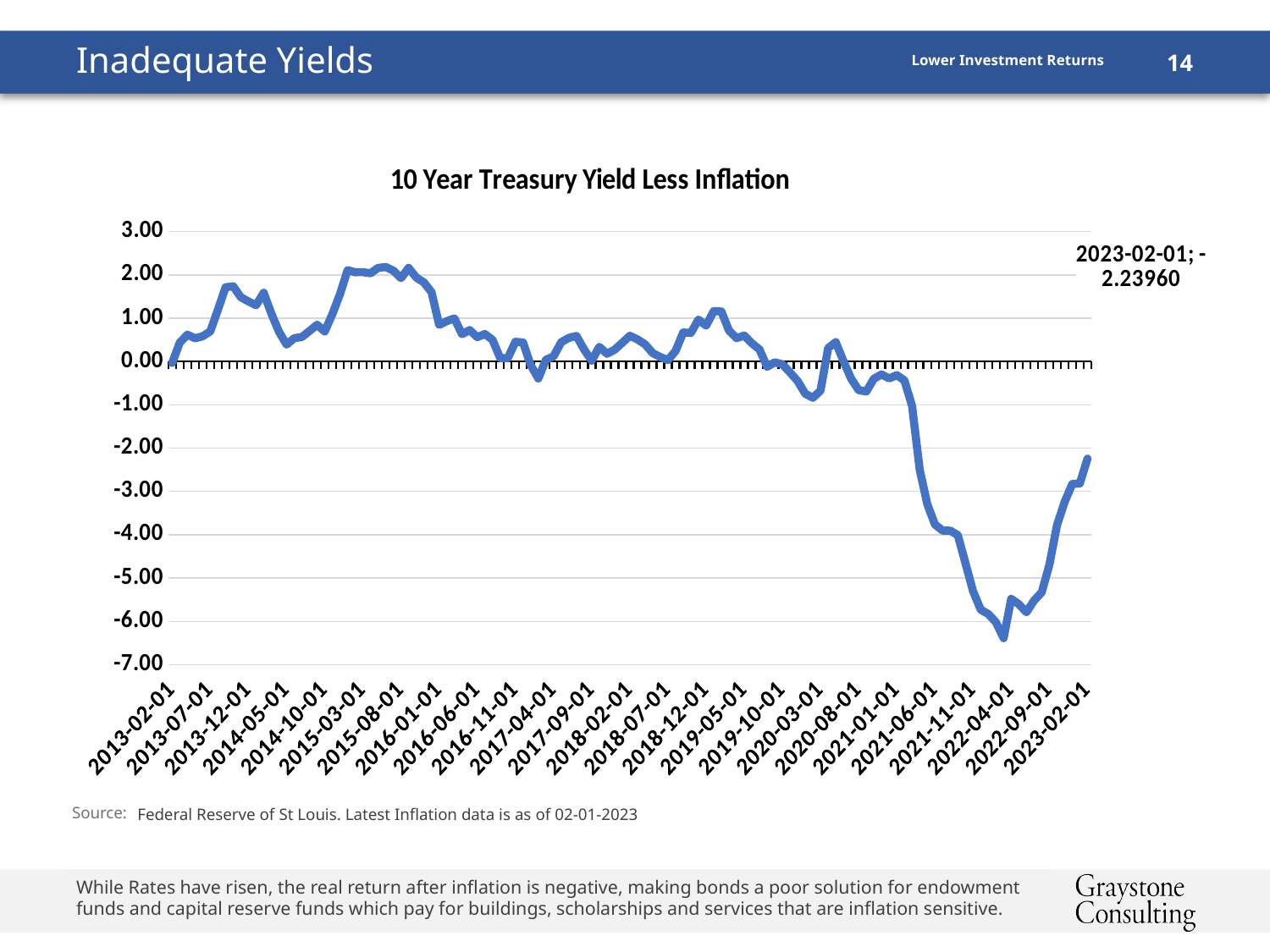
What kind of chart is shown on the slide? line chart Is the value for 2022-04-01 greater or less than -5.00? less What value is labelled on the chart for 2023-02-01? -2.23960 Is the value for 2015-08-01 greater or less than 1.00? greater Is the value for 2020-08-01 greater or less than 0.00? less What is the title of the chart? 10 Year Treasury Yield Less Inflation What is the lowest value shown on the vertical axis? -7.00 Does the line rise or fall between 2021-01-01 and 2022-04-01? fall Does the line rise or fall between 2022-04-01 and 2023-02-01? rise Which is larger, the value for 2015-08-01 or the value for 2023-02-01? 2015-08-01